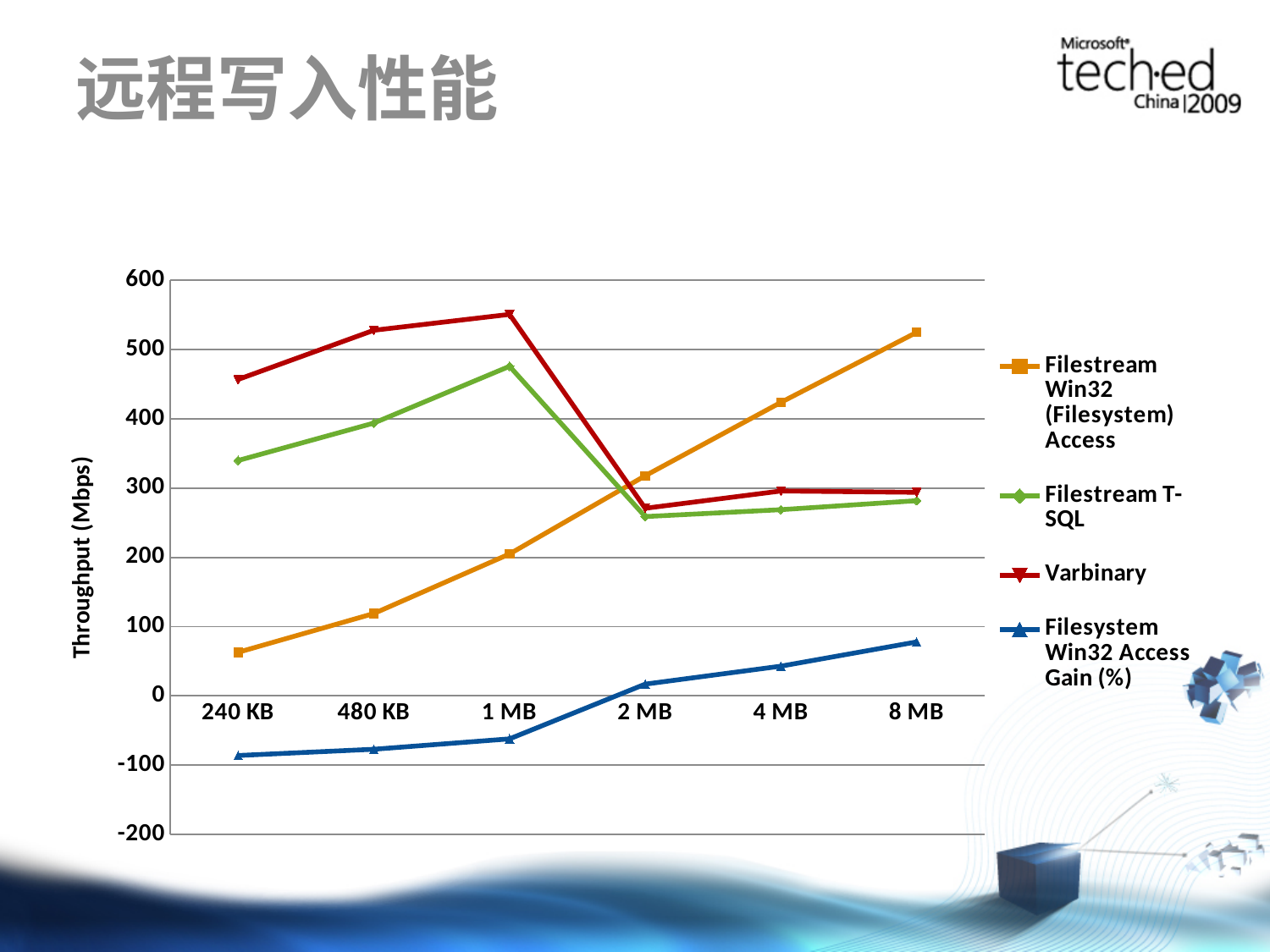
Which series has the highest value at 8 MB? Filestream Win32 (Filesystem) Access Which series has the lowest value at 240 KB? Filesystem Win32 Access Gain (%) At 480 KB, which is larger: Varbinary or Filestream T-SQL? Varbinary What is the title of the vertical axis? Throughput (Mbps) How many categories are shown on the x axis? 6 What kind of chart is shown on the slide? line chart Do the values for Filestream Win32 (Filesystem) Access rise or fall from 240 KB to 8 MB? rise How many series does the legend list? 4 Is the value for Filestream Win32 (Filesystem) Access at 240 KB greater or less than 100? less Which series has the highest value at 1 MB? Varbinary Is the value for Varbinary at 1 MB greater or less than 500? greater Is the value for Filestream T-SQL at 2 MB greater or less than 300? less